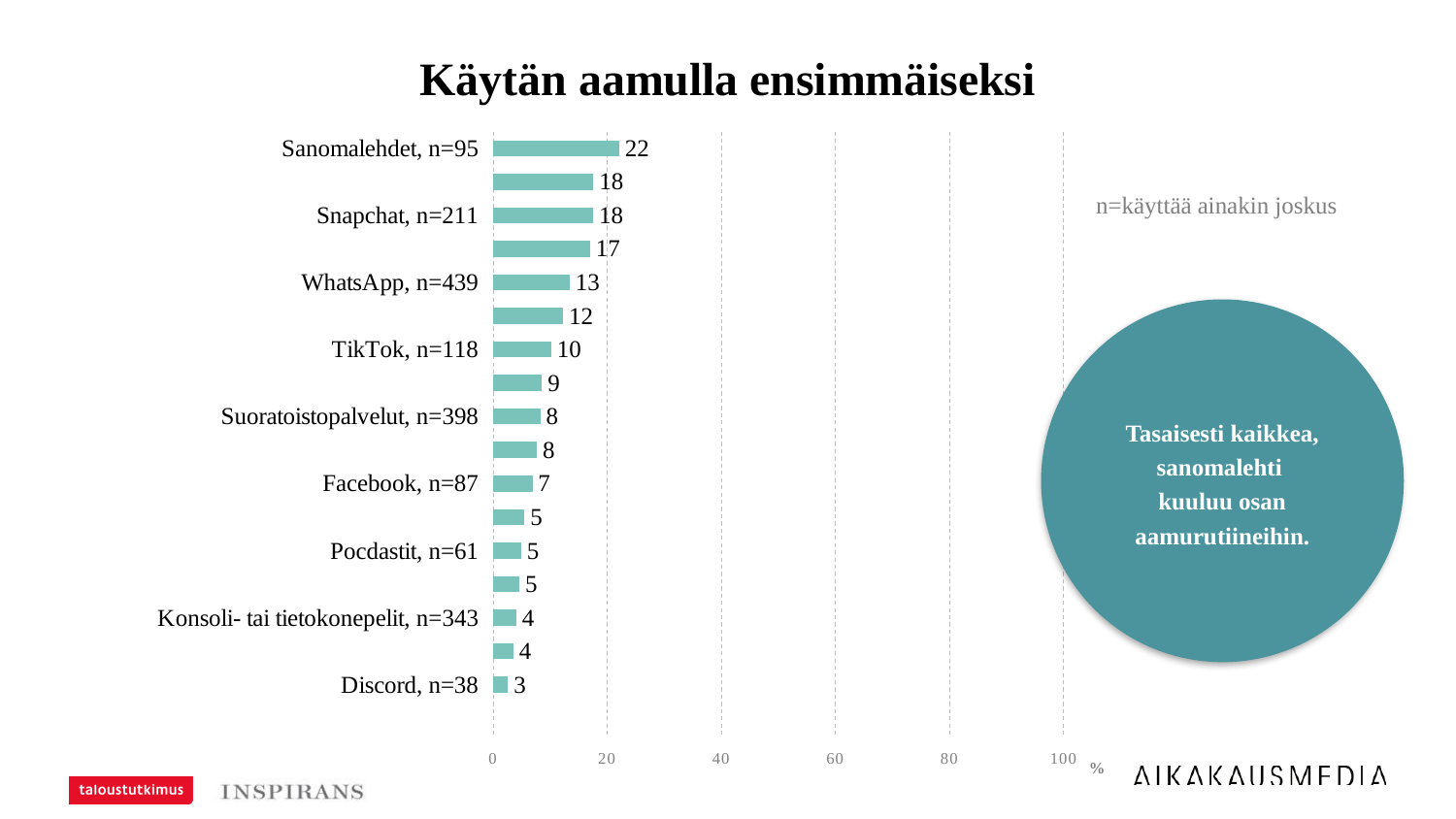
What is the value for Facebook, n=87? 7 How many bars are plotted in the chart? 17 What is the value for Konsoli- tai tietokonepelit, n=343? 4 What is the difference between the values for Snapchat, n=211 and TikTok, n=118? 8 Which labelled category has the lowest value? Discord, n=38 Which labelled category has the highest value? Sanomalehdet, n=95 Is the value for Sanomalehdet, n=95 greater or less than 40? less What is the value for WhatsApp, n=439? 13 What is the title of the chart? Käytän aamulla ensimmäiseksi What kind of chart is shown on the slide? bar chart What is the value for Sanomalehdet, n=95? 22 Which is larger, the value for Suoratoistopalvelut, n=398 or the value for Podcastit, n=61? Suoratoistopalvelut, n=398